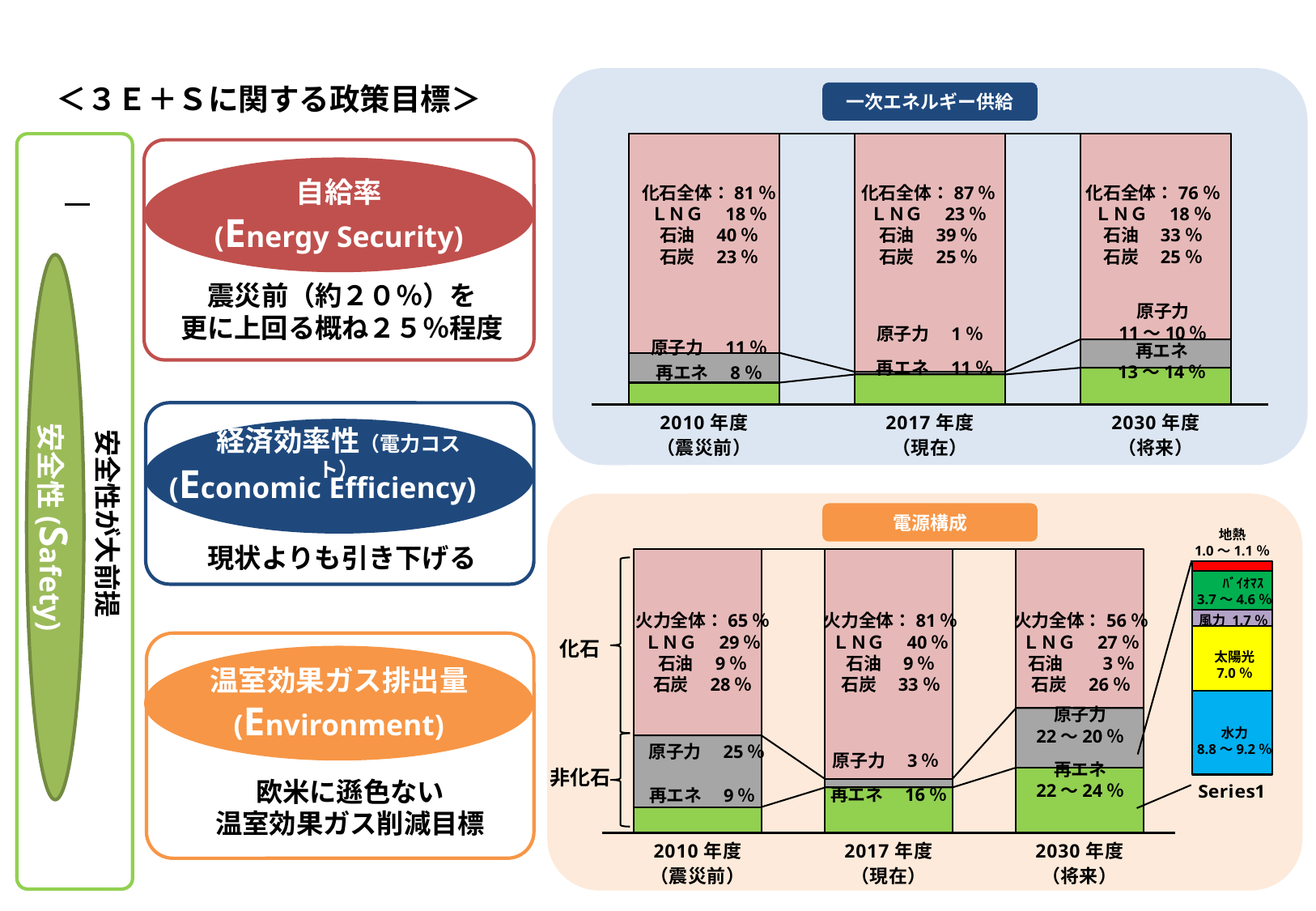
In the 電源構成 chart, what is the 原子力 value for 2010年度? 25% In the 一次エネルギー供給 chart, which year has the lowest 原子力 value? 2017年度 In the 電源構成 chart, what is the 火力全体 value for 2030年度? 56% In the 電源構成 chart, is the LNG value for 2017年度 larger or smaller than the LNG value for 2010年度? larger What kind of chart is the 電源構成 chart? stacked bar chart In the 一次エネルギー供給 chart, what is the difference between the 石油 values for 2010年度 and 2030年度? 7% In the 一次エネルギー供給 chart, which year has the highest 化石全体 value? 2017年度 In the 一次エネルギー供給 chart, how many years are shown on the x axis? 3 In the 電源構成 chart, which year has the highest 石炭 value? 2017年度 In the 一次エネルギー供給 chart, what is the 再エネ value for 2010年度? 8% In the 電源構成 chart, what is the 太陽光 value in the 2030年度 renewable breakdown? 7.0% In the 一次エネルギー供給 chart, what is the 化石全体 value for 2017年度? 87%